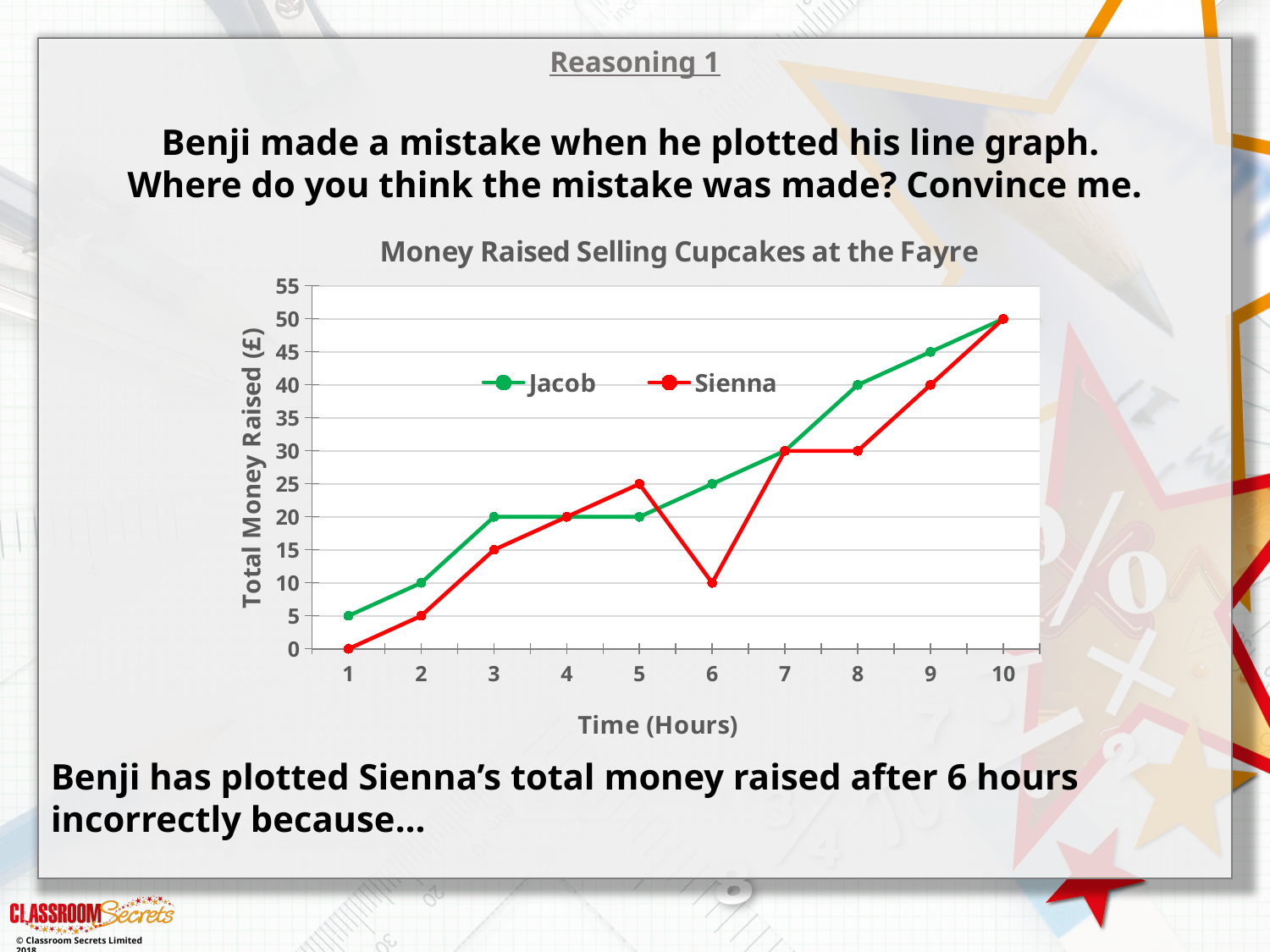
How many series does the legend list? 2 At which hour is Jacob's total money raised the highest? 10 Does Jacob's total money raised generally rise or fall as time increases? rise After 5 hours, who has raised more money, Jacob or Sienna? Sienna What is the title of the chart? Money Raised Selling Cupcakes at the Fayre What is Sienna's total money raised after 6 hours? 10 What is Sienna's total money raised after 1 hour? 0 What is the difference between Jacob's and Sienna's total money raised after 6 hours? 15 At which hour is Sienna's total money raised the lowest? 1 What is Jacob's total money raised after 3 hours? 20 What type of chart is shown on the slide? line chart How many time points are plotted along the x axis? 10